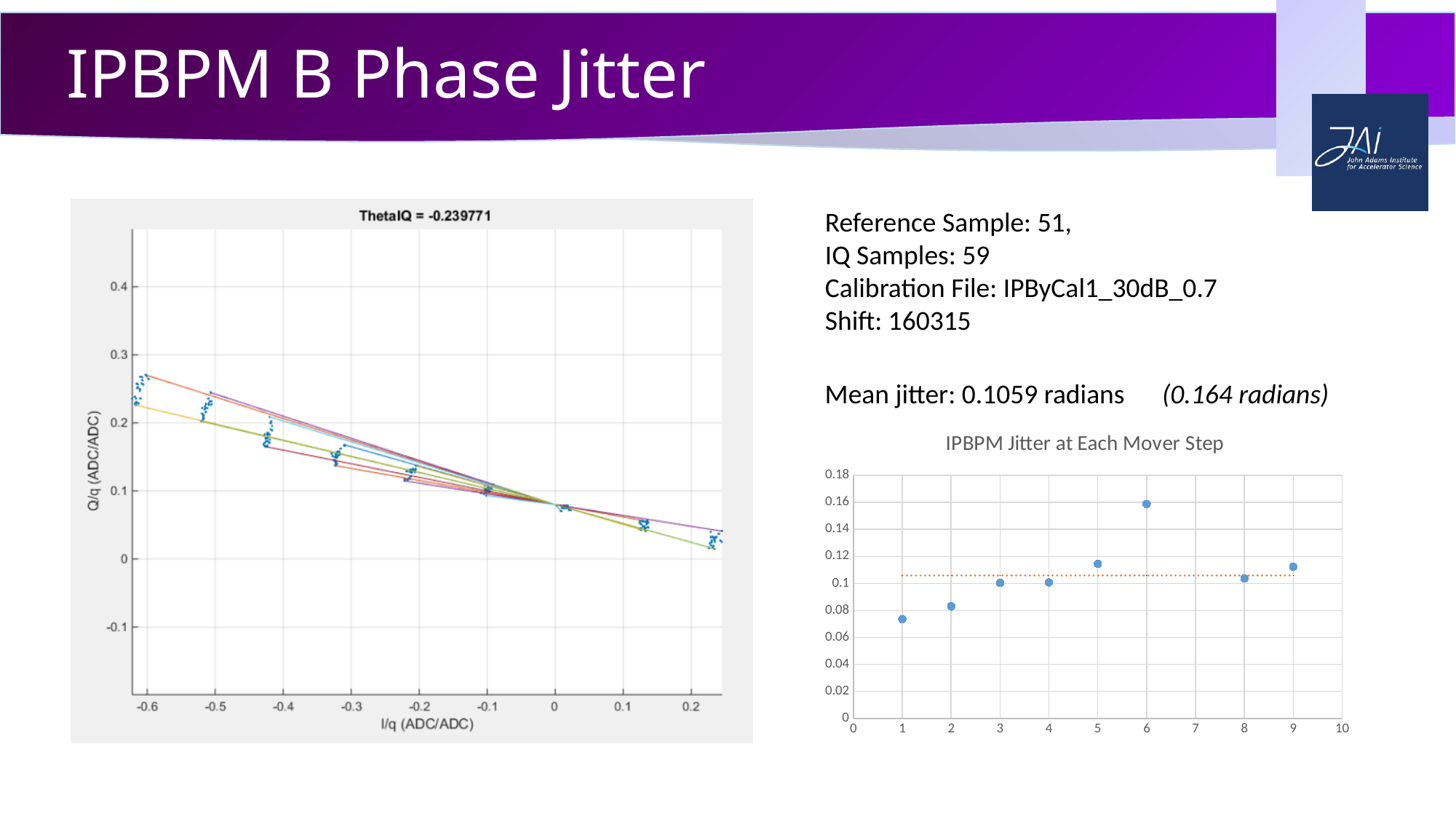
In the 'IPBPM Jitter at Each Mover Step' chart, is the value at mover step 6 greater or less than 0.14? greater In the chart on the left of the slide, does Q/q rise or fall as I/q increases along the x axis? fall What is the title of the chart on the right of the slide? IPBPM Jitter at Each Mover Step In the chart on the left of the slide, what is the title shown above the plot? ThetaIQ = -0.239771 In the 'IPBPM Jitter at Each Mover Step' chart, which mover step has the lowest jitter? 1 In the 'IPBPM Jitter at Each Mover Step' chart, what is the maximum value shown on the y axis? 0.18 In the 'IPBPM Jitter at Each Mover Step' chart, which has the larger jitter, mover step 2 or mover step 5? mover step 5 In the 'IPBPM Jitter at Each Mover Step' chart, what kind of chart is shown? scatter chart In the 'IPBPM Jitter at Each Mover Step' chart, is the value at mover step 5 greater or less than 0.1? greater In the 'IPBPM Jitter at Each Mover Step' chart, is the value at mover step 1 greater or less than 0.08? less In the 'IPBPM Jitter at Each Mover Step' chart, which mover step has the highest jitter? 6 In the 'IPBPM Jitter at Each Mover Step' chart, how many data points are plotted? 8